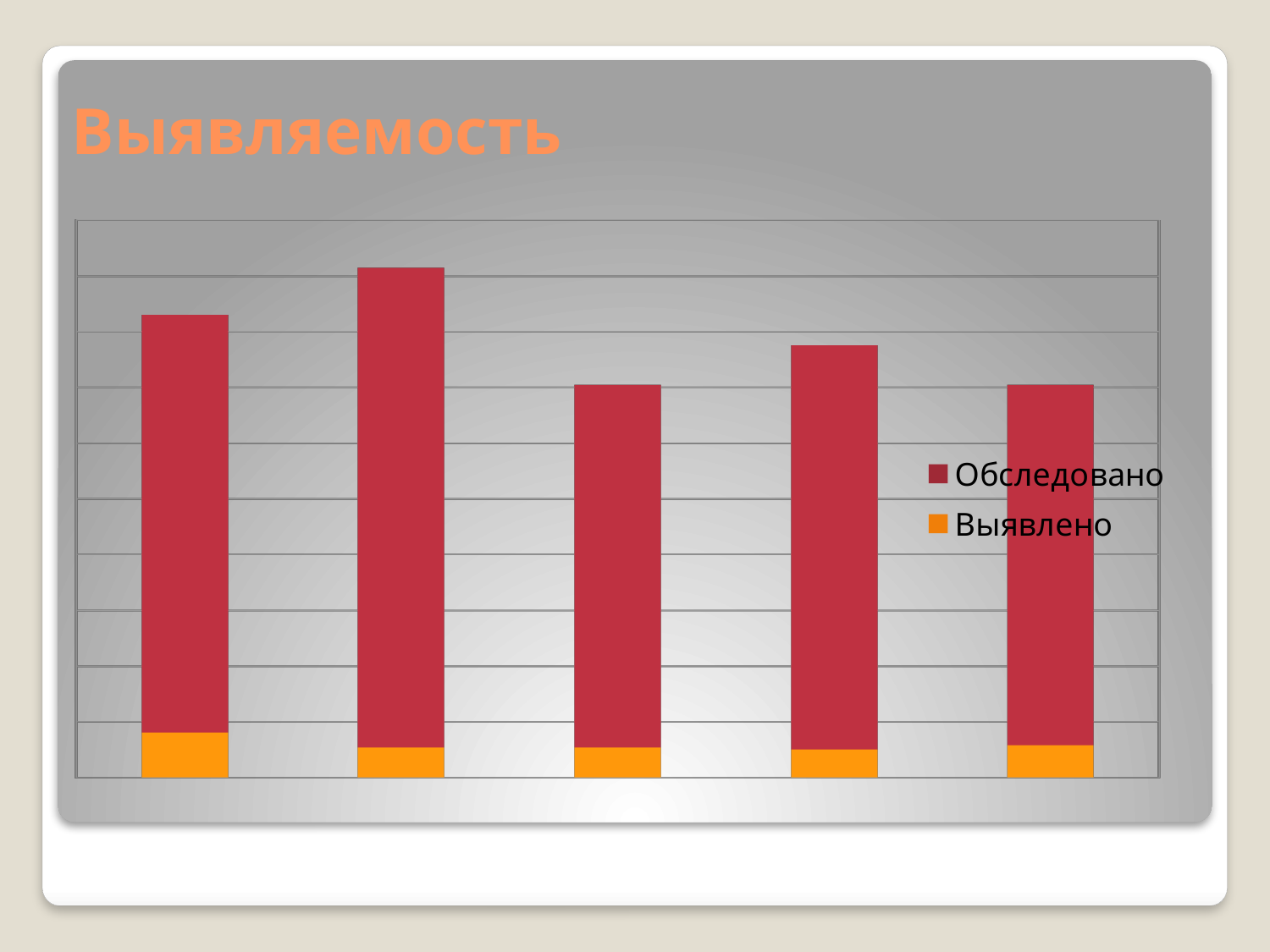
What is the title of the slide containing the chart? Выявляемость What kind of chart is shown on the slide? Stacked bar chart Which bar, counting from the left, is the tallest overall? The second bar Do the bar heights rise steadily, fall steadily, or fluctuate from left to right? Fluctuate Which series is shown in orange in the legend? Выявлено Which is taller overall, the first bar from the left or the fourth bar from the left? The first bar How many bars are plotted in the chart? 5 How many series does the legend list? 2 Which series, Обследовано or Выявлено, makes up the larger part of each bar? Обследовано Which is taller overall, the first bar from the left or the second bar from the left? The second bar